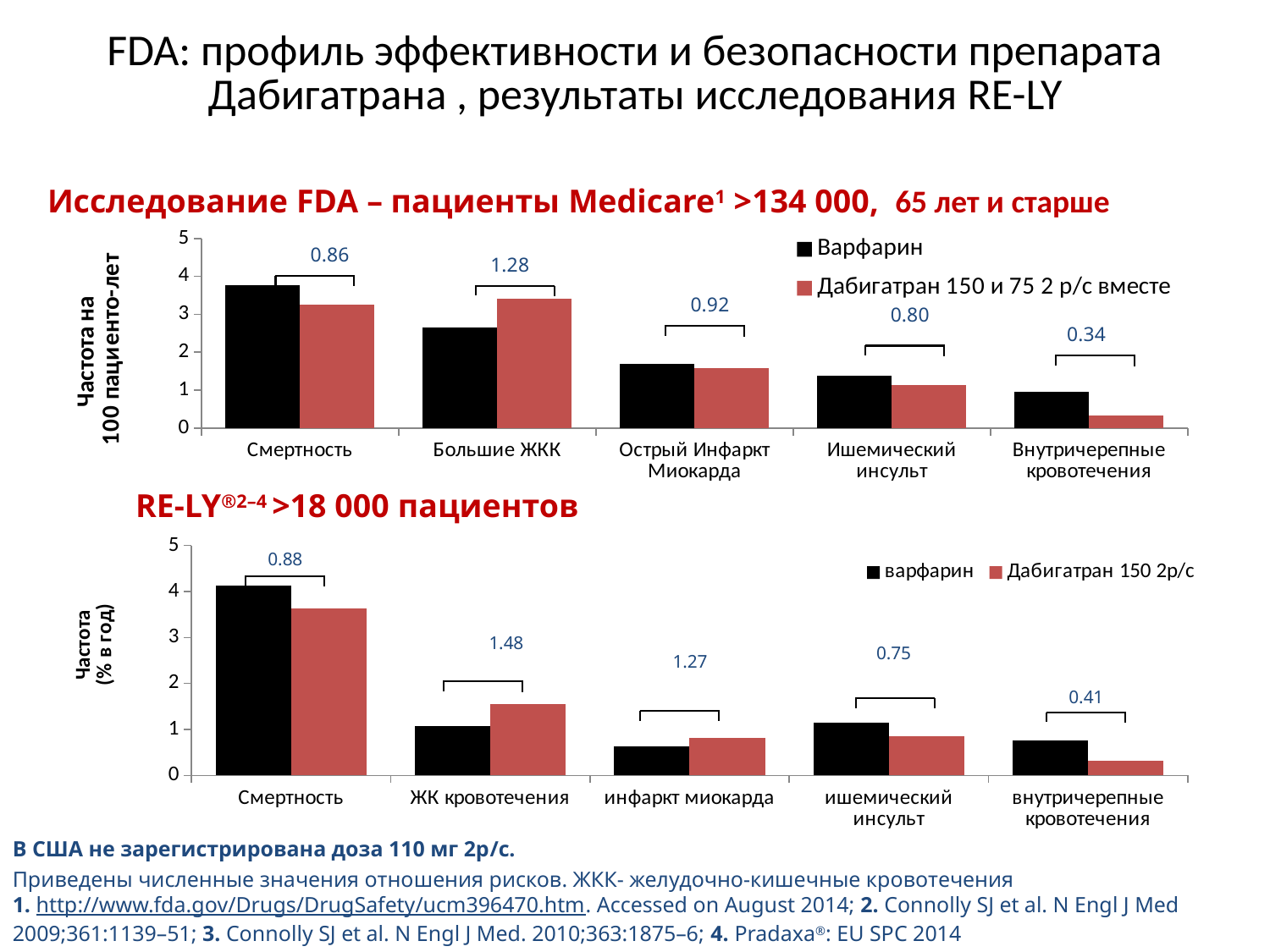
In the top chart (Исследование FDA – пациенты Medicare), for Большие ЖКК, which series has the taller bar, Варфарин or Дабигатран? Дабигатран In the bottom chart (RE-LY), what hazard ratio is printed above the ЖК кровотечения bars? 1.48 How many categories are shown on the x axis of the bottom chart (RE-LY)? 5 In the bottom chart (RE-LY), for ишемический инсульт, which series has the taller bar, варфарин or Дабигатран 150 2р/с? варфарин In the top chart (Исследование FDA – пациенты Medicare), which category has the lowest Дабигатран bar? Внутричерепные кровотечения In the top chart (Исследование FDA – пациенты Medicare), which category has the highest Варфарин bar? Смертность In the bottom chart (RE-LY), what hazard ratio is printed above the внутричерепные кровотечения bars? 0.41 How many series does the legend of the top chart (Исследование FDA – пациенты Medicare) list? 2 In the bottom chart (RE-LY), is the Дабигатран 150 2р/с value for внутричерепные кровотечения greater or less than 1? less In the top chart (Исследование FDA – пациенты Medicare), what hazard ratio is printed above the Смертность bars? 0.86 In the top chart (Исследование FDA – пациенты Medicare), is the Варфарин value for Смертность greater or less than 3? greater